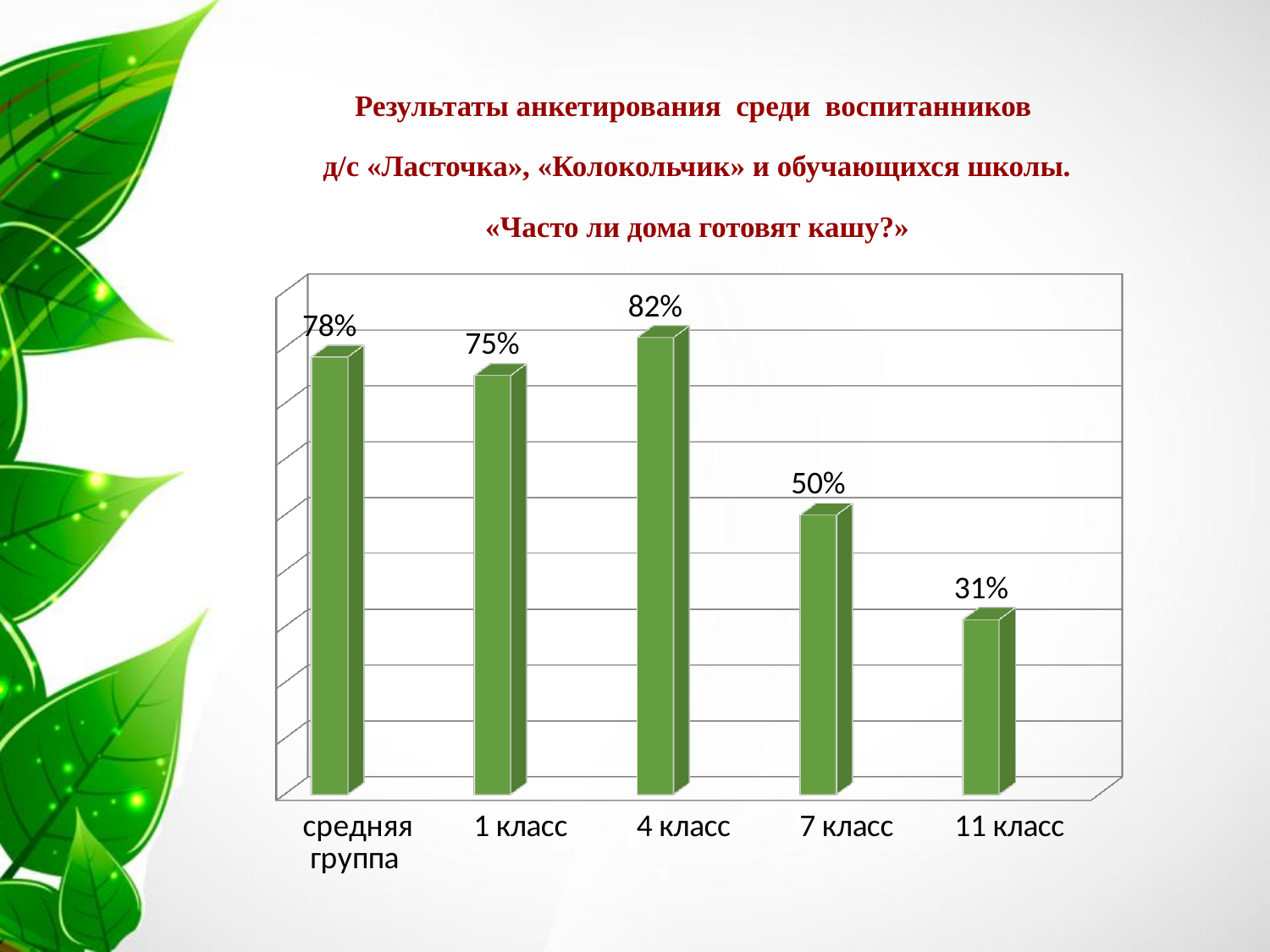
What is the value for 7 класс? 50% Which is larger, the value for 7 класс or the value for 1 класс? 1 класс Do the values rise or fall from 4 класс to 11 класс? fall What is the value for 11 класс? 31% What is the difference between the values for 4 класс and 11 класс? 51% Which category has the highest value? 4 класс What kind of chart is shown on the slide? bar chart What is the value for 4 класс? 82% What is the value for средняя группа? 78% What is the difference between the values for средняя группа and 1 класс? 3% How many categories are shown on the chart? 5 Which category has the lowest value? 11 класс